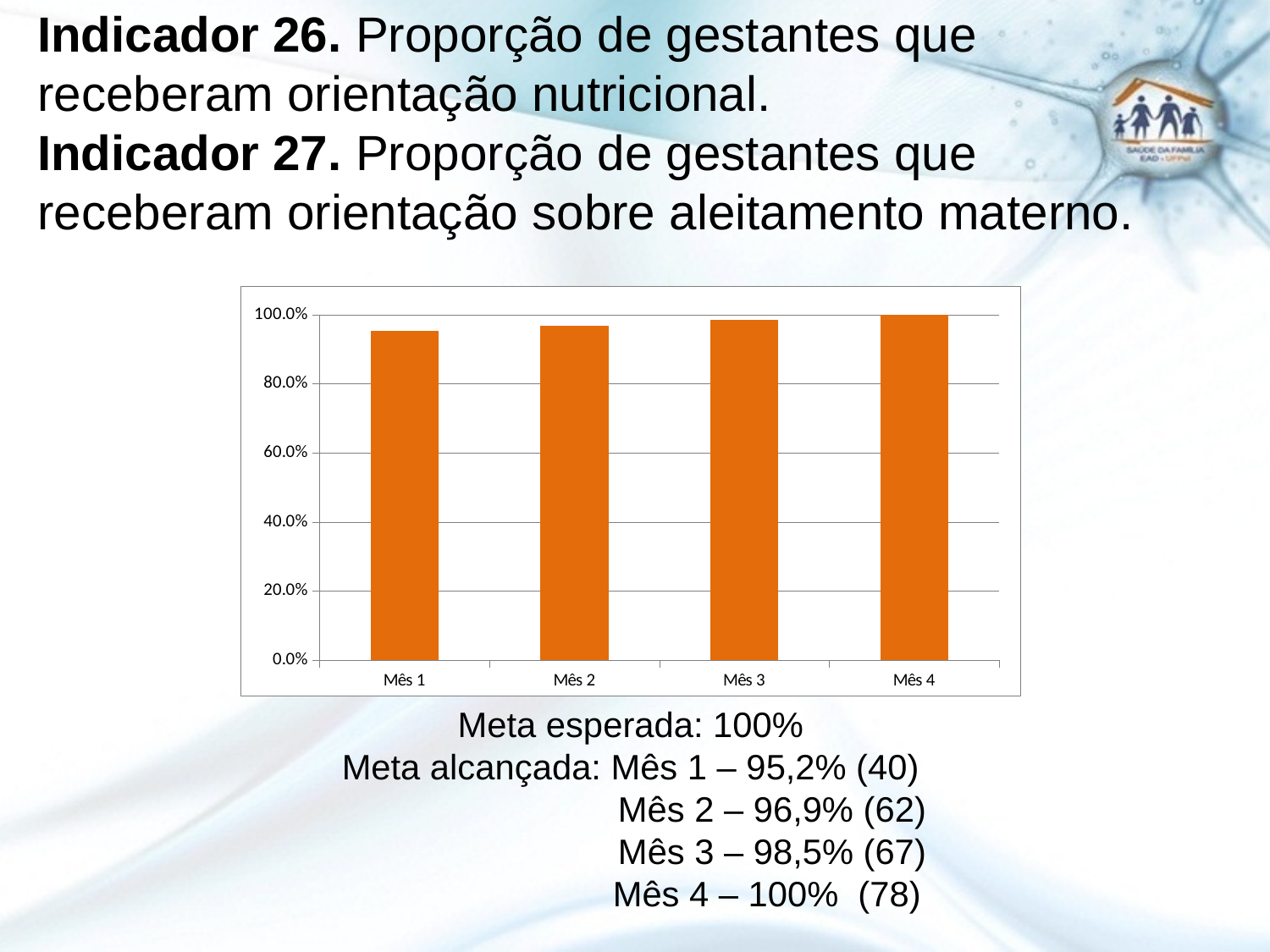
According to the slide, what value was reached in Mês 2? 96,9% What kind of chart is shown on the slide? Bar chart According to the slide, what value was reached in Mês 3? 98,5% Is the value for Mês 1 greater or less than 80.0%? greater What is the expected target (meta esperada) stated on the slide? 100% Do the values rise or fall from Mês 1 to Mês 4? Rise According to the slide, what value was reached in Mês 4? 100% What is the difference between the values for Mês 4 and Mês 1, using the values printed on the slide? 4,8% Which month has the highest value in the chart? Mês 4 According to the slide, what value was reached in Mês 1? 95,2% How many categories (months) are plotted on the x axis of the chart? 4 Which month has the lowest value in the chart? Mês 1